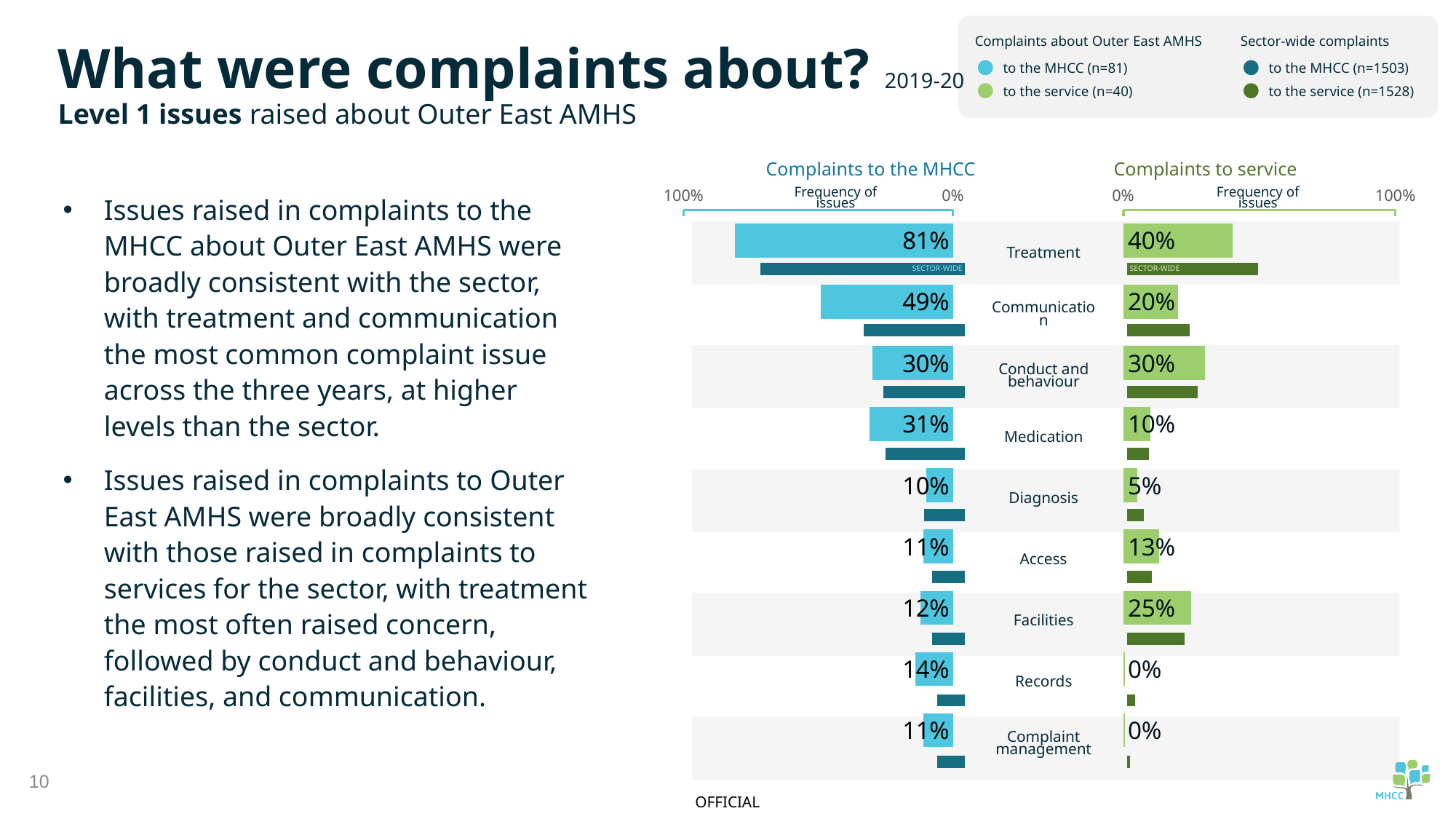
In the 'Complaints to the MHCC' chart, what is the value for Treatment? 81% In the 'Complaints to service' chart, which issue has the highest value? Treatment In the 'Complaints to service' chart, what is the difference between the values for Treatment and Conduct and behaviour? 10% What type of chart is the 'Complaints to service' chart? Bar chart In the 'Complaints to the MHCC' chart, what is the difference between the values for Treatment and Communication? 32% In the 'Complaints to the MHCC' chart, which issue has the highest value? Treatment In the 'Complaints to the MHCC' chart, which issue has the lowest value? Diagnosis In the 'Complaints to service' chart, what is the value for Facilities? 25% In the 'Complaints to the MHCC' chart, what is the value for Communication? 49% How many issue categories are shown in the 'Complaints to the MHCC' chart? 9 Is the value for Medication larger in the 'Complaints to the MHCC' chart or the 'Complaints to service' chart? Complaints to the MHCC In the 'Complaints to service' chart, what is the value for Diagnosis? 5%